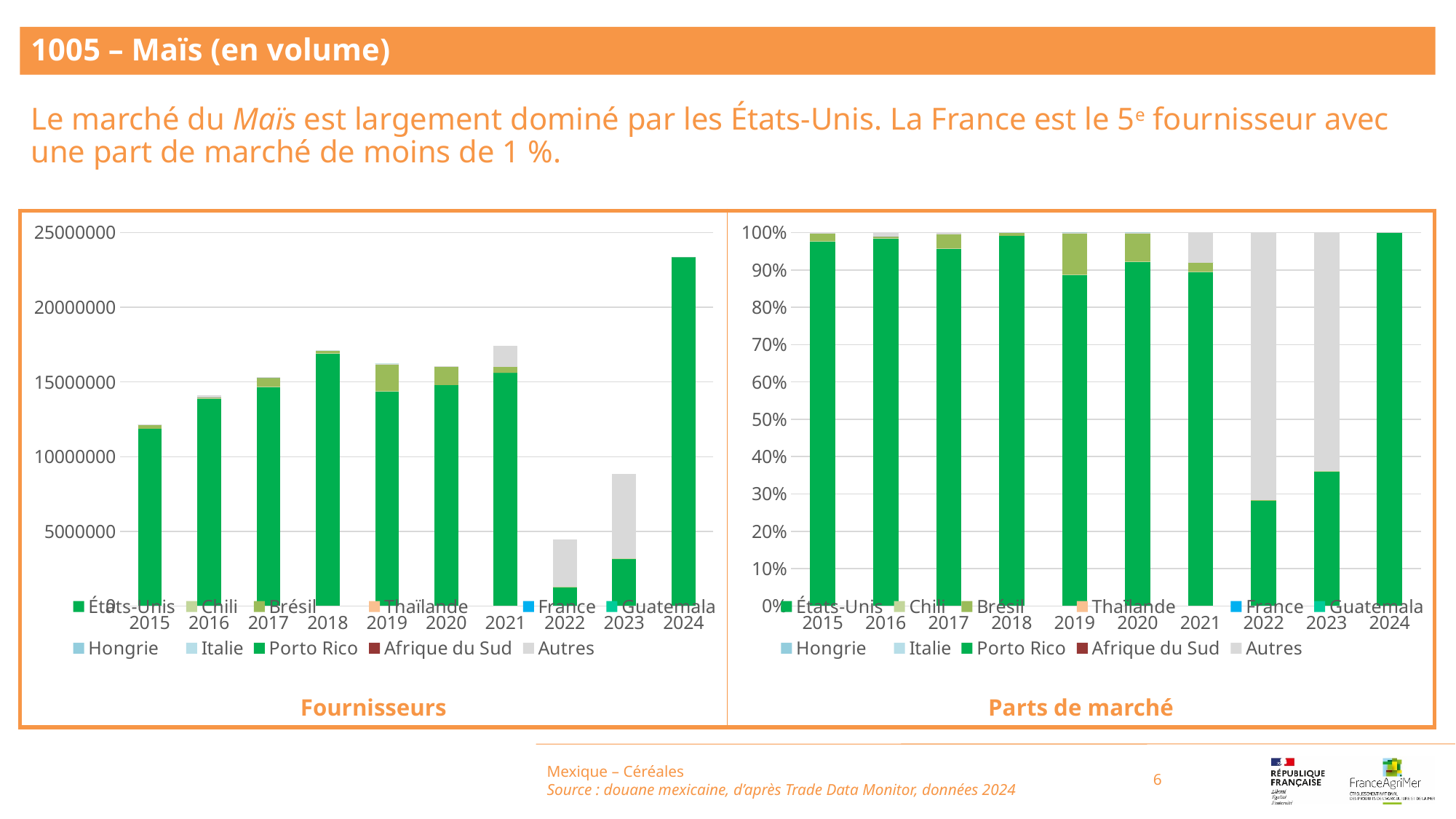
In the 'Fournisseurs' chart, is the total for 2024 greater or less than 20000000? greater In the 'Parts de marché' chart, is the share of États-Unis in 2022 greater or less than 50%? less In the 'Parts de marché' chart, which year has the smallest share for États-Unis? 2022 What is the title of the chart on the right side of the slide? Parts de marché In the 'Parts de marché' chart, is the share of États-Unis in 2024 greater or less than 90%? greater How many years are shown on the x axis of the 'Fournisseurs' chart? 10 In the 'Fournisseurs' chart, is the total bar for 2018 larger or smaller than the total bar for 2019? larger In the 'Fournisseurs' chart, which year has the highest total bar? 2024 In the 'Fournisseurs' chart, which year has the lowest total bar? 2022 How many series does the legend of the 'Parts de marché' chart list? 11 What kind of chart is the 'Fournisseurs' chart on the left? stacked bar chart